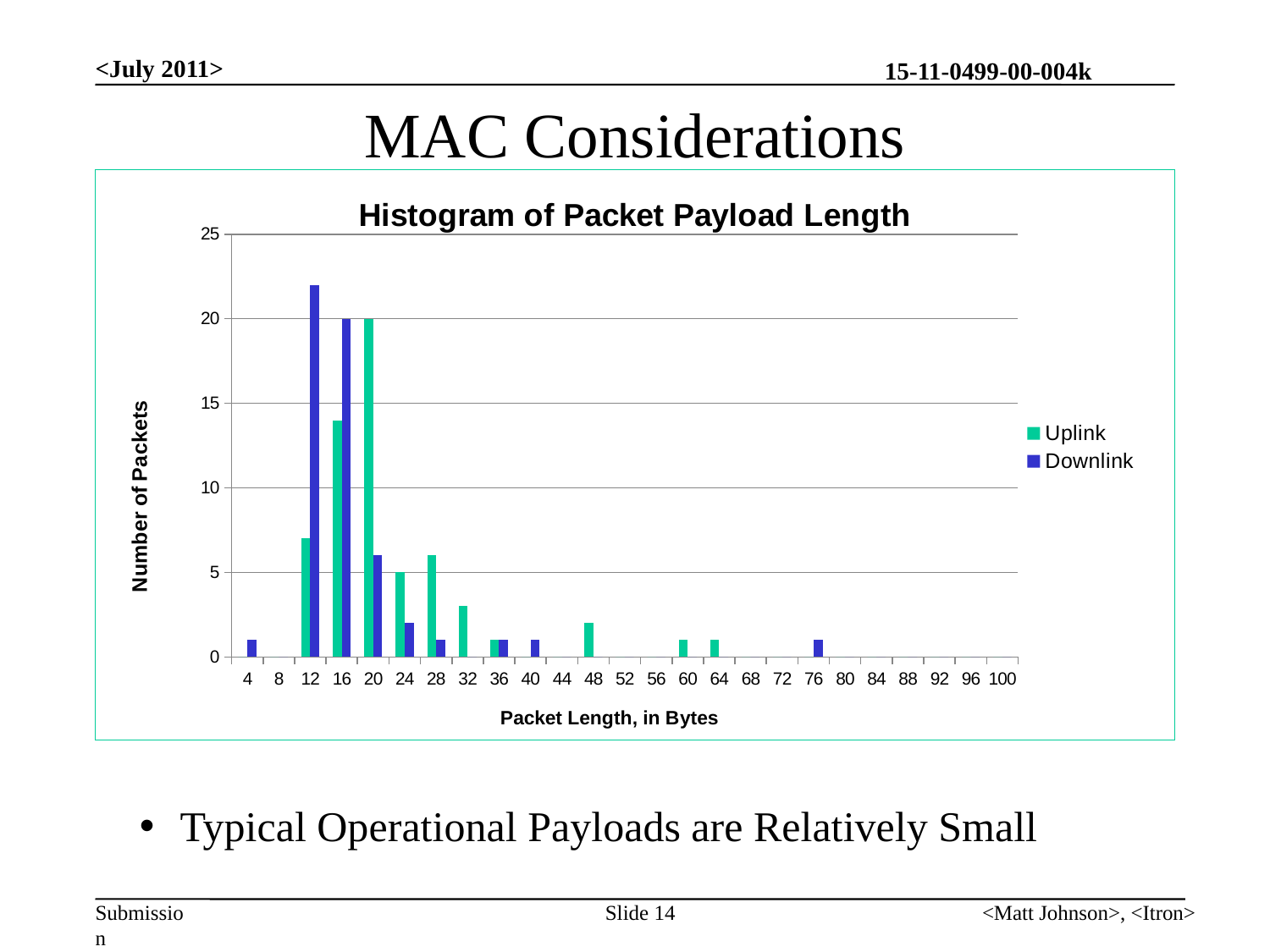
How many series does the legend list? 2 Which colour represents the Uplink series in the legend? Green At a packet length of 12 bytes, which series has the larger value, Uplink or Downlink? Downlink What is the Downlink value at a packet length of 16 bytes? 20 Is the Downlink value at 12 bytes greater or less than 20? greater How many packet length categories are shown on the x axis? 25 What is the title of the chart? Histogram of Packet Payload Length At which packet length is the Uplink series highest? 20 Is the Uplink value at 16 bytes greater or less than 15? less What type of chart is shown on the slide? Bar chart At which packet length is the Downlink series highest? 12 What is the Uplink value at a packet length of 20 bytes? 20